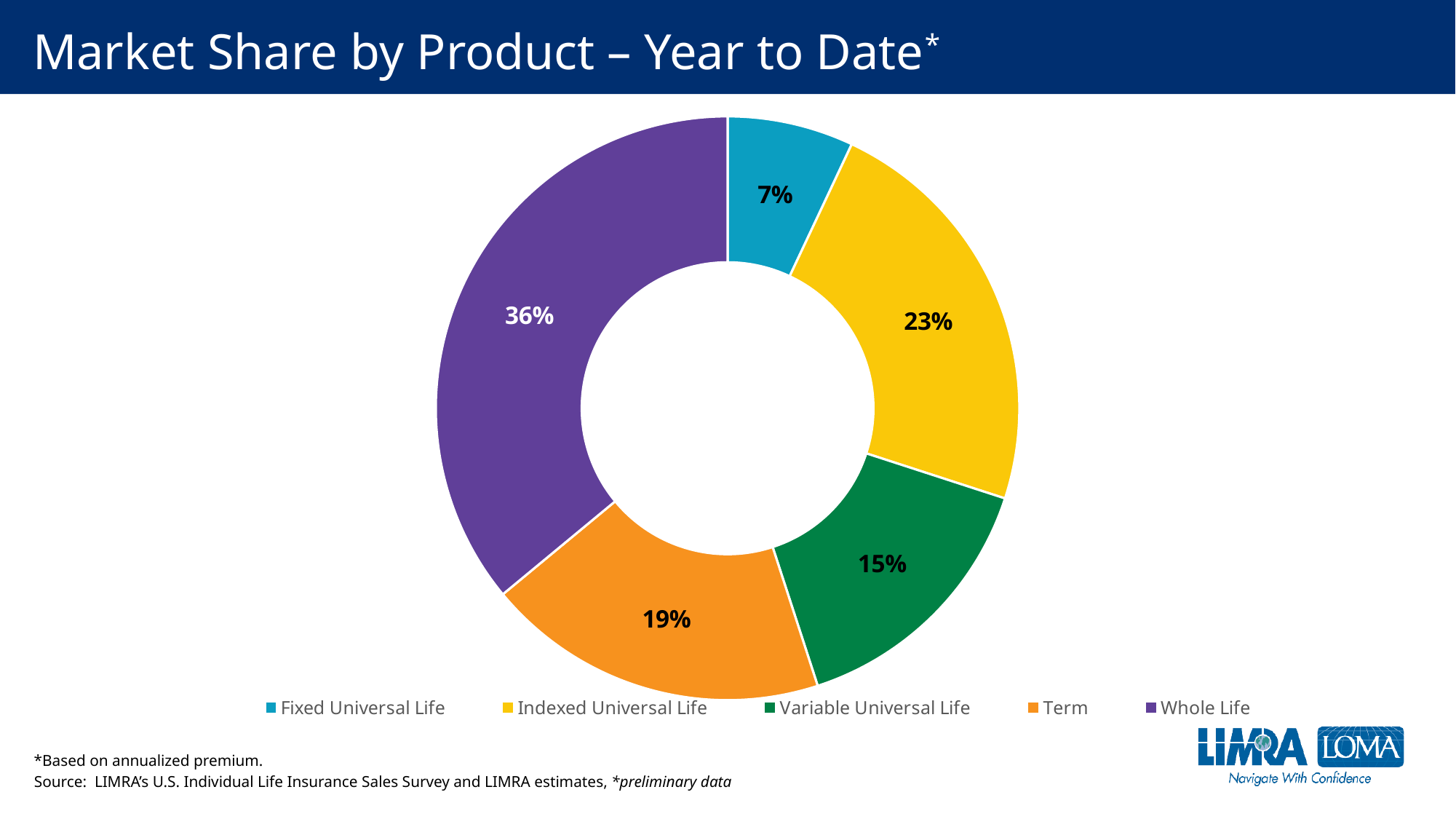
What is the market share for Indexed Universal Life? 23% What kind of chart is shown on the slide? Doughnut (pie) chart What is the difference in market share between Whole Life and Indexed Universal Life? 13 percentage points What is the market share for Variable Universal Life? 15% What is the market share for Whole Life? 36% Which product has the largest market share? Whole Life What is the title of the chart? Market Share by Product – Year to Date* Which product has the smallest market share? Fixed Universal Life How many products are shown in the chart? 5 What is the market share for Term? 19% Which has a larger market share, Term or Variable Universal Life? Term What is the market share for Fixed Universal Life? 7%